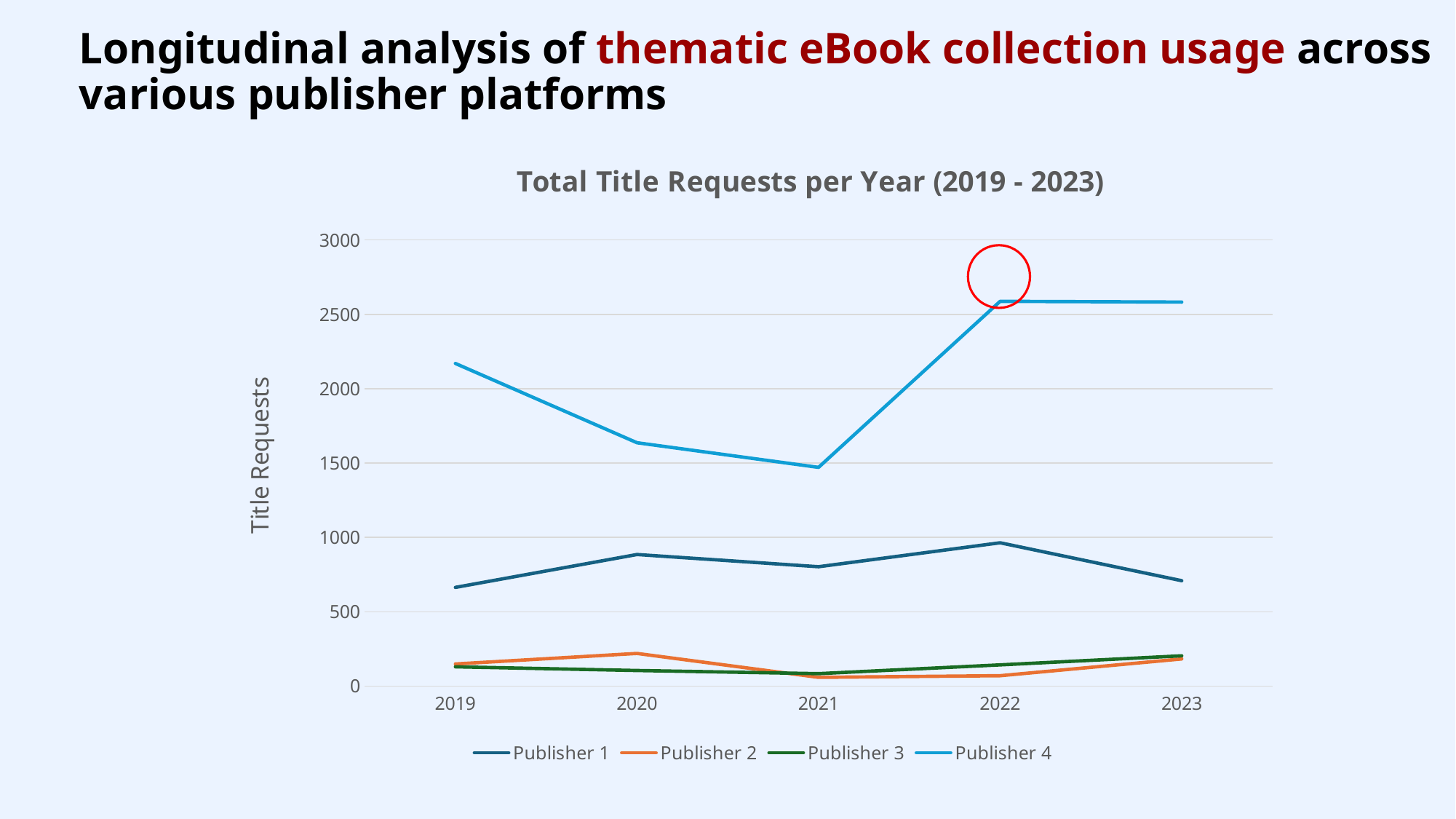
In 2020, which is larger: Publisher 2 or Publisher 3? Publisher 2 Is the value for Publisher 1 in 2019 greater or less than 500? greater What kind of chart is shown on the slide? Line chart Is the value for Publisher 4 in 2022 greater or less than 2500? greater Is the value for Publisher 1 in 2022 greater or less than 1000? less In which year does Publisher 4 have its lowest value? 2021 Do the values for Publisher 4 rise or fall from 2019 to 2021? fall What is the title of the chart? Total Title Requests per Year (2019 - 2023) How many years are plotted along the x axis? 5 In which year does Publisher 1 have its highest value? 2022 How many series does the legend list? 4